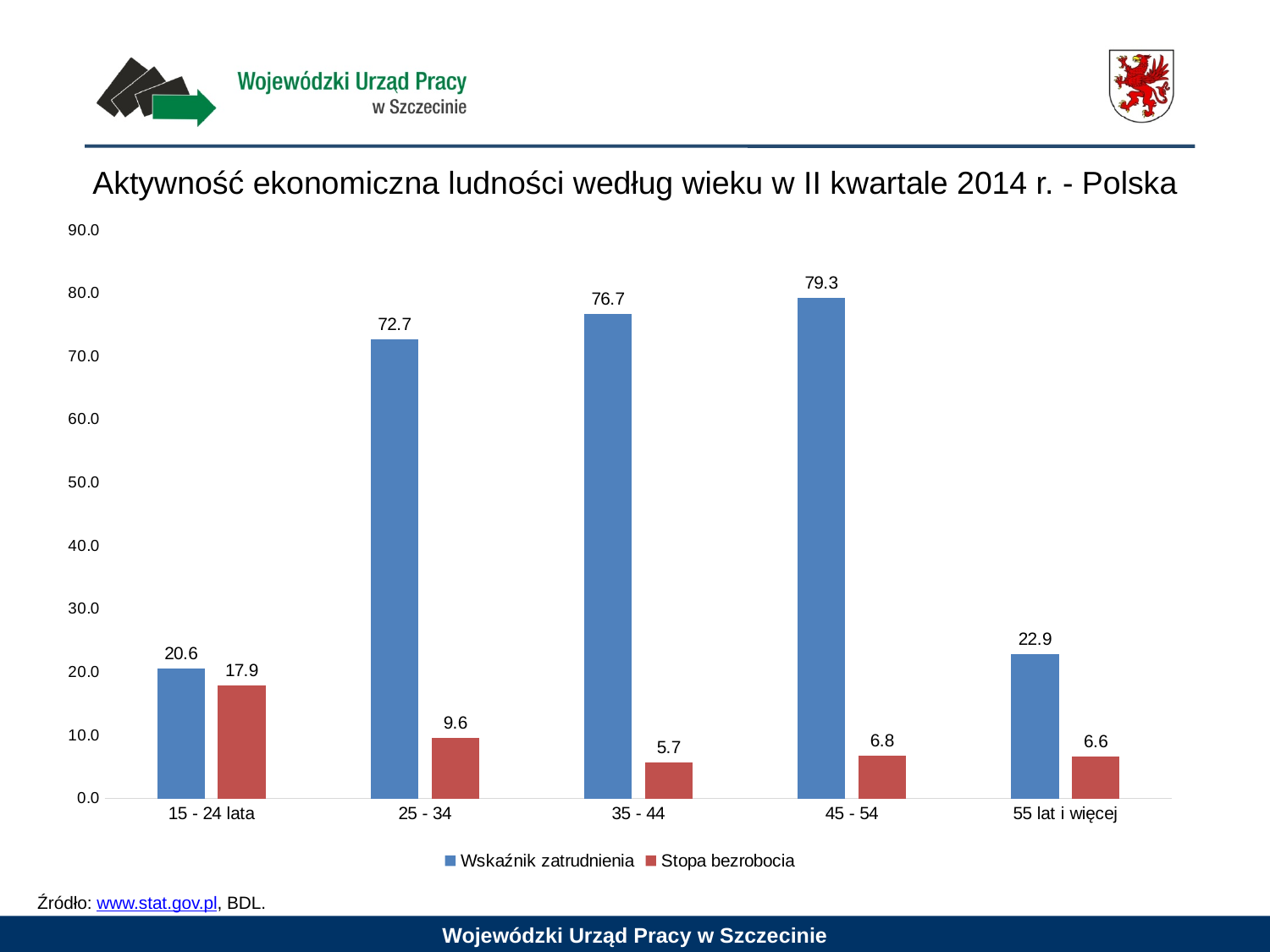
What colour are the Stopa bezrobocia bars? Red How many series does the legend list? 2 Which age group has the highest Wskaźnik zatrudnienia? 45 - 54 How many age groups are shown on the x axis? 5 Does Stopa bezrobocia rise or fall from the 15 - 24 lata group to the 35 - 44 group? Fall What is the value of Stopa bezrobocia for the 15 - 24 lata age group? 17.9 Which is larger: Stopa bezrobocia for 25 - 34 or for 45 - 54? 25 - 34 What is the value of Wskaźnik zatrudnienia for the 25 - 34 age group? 72.7 What kind of chart is shown on the slide? Bar chart What is the value of Stopa bezrobocia for the 55 lat i więcej age group? 6.6 Which age group has the lowest Stopa bezrobocia? 35 - 44 What is the difference between Wskaźnik zatrudnienia and Stopa bezrobocia for the 45 - 54 age group? 72.5